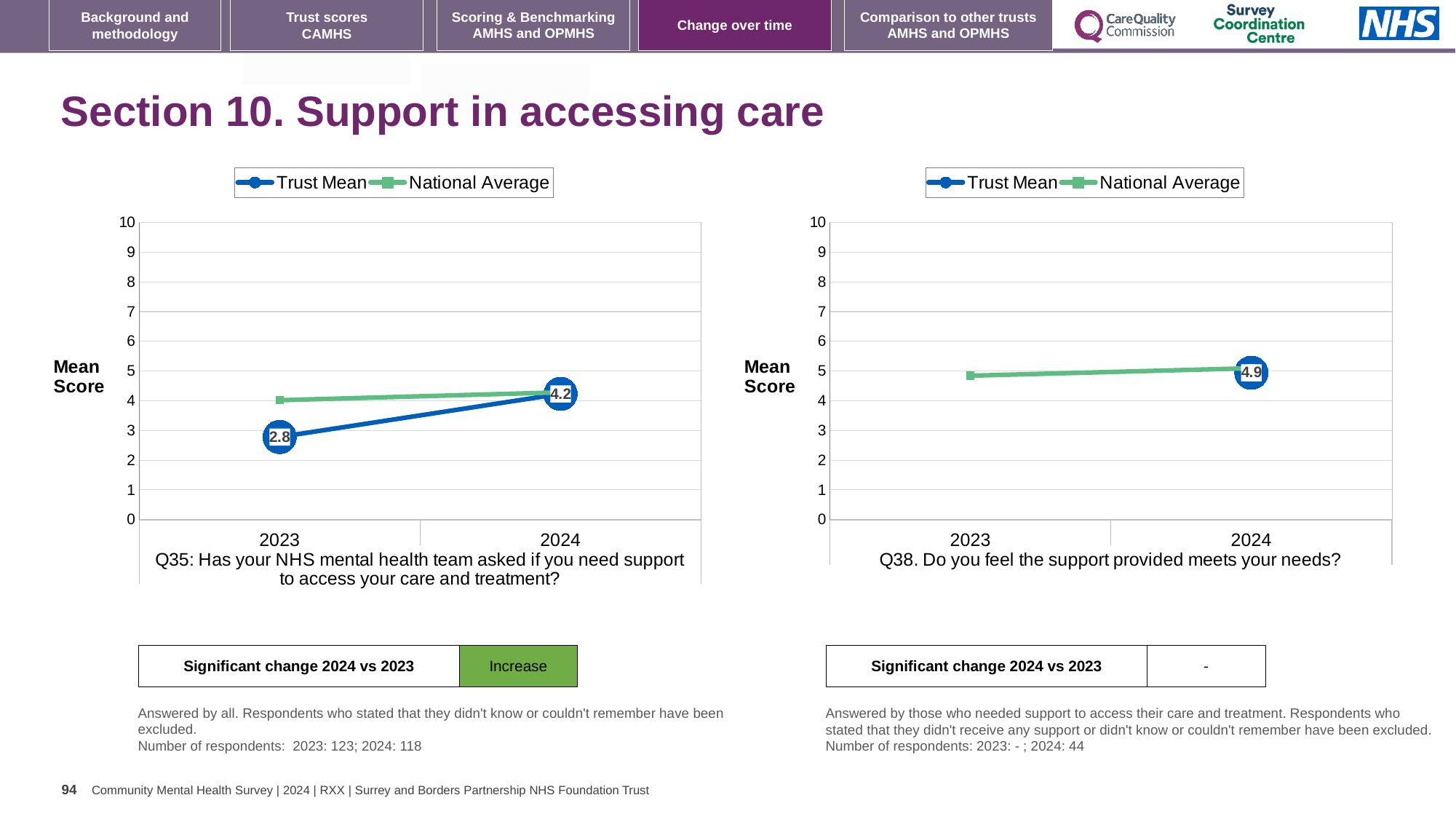
What kind of chart is the right chart (Q38)? line chart How many series does the legend of the left chart (Q35) list? 2 In the left chart (Q35), is the National Average value for 2023 greater or less than 3? greater In the left chart (Q35), by how much did the Trust Mean change from 2023 to 2024? 1.4 In the right chart (Q38), what is the Trust Mean value for 2024? 4.9 What is the y-axis label of the left chart (Q35)? Mean Score In the left chart (Q35), what is the Trust Mean value for 2024? 4.2 How many years are shown on the x axis of the right chart (Q38)? 2 In the left chart (Q35), what is the Trust Mean value for 2023? 2.8 In the left chart (Q35), which is higher in 2023: the Trust Mean or the National Average? National Average In the left chart (Q35), does the Trust Mean rise or fall from 2023 to 2024? rise In the left chart (Q35), is the National Average value for 2023 greater or less than 5? less